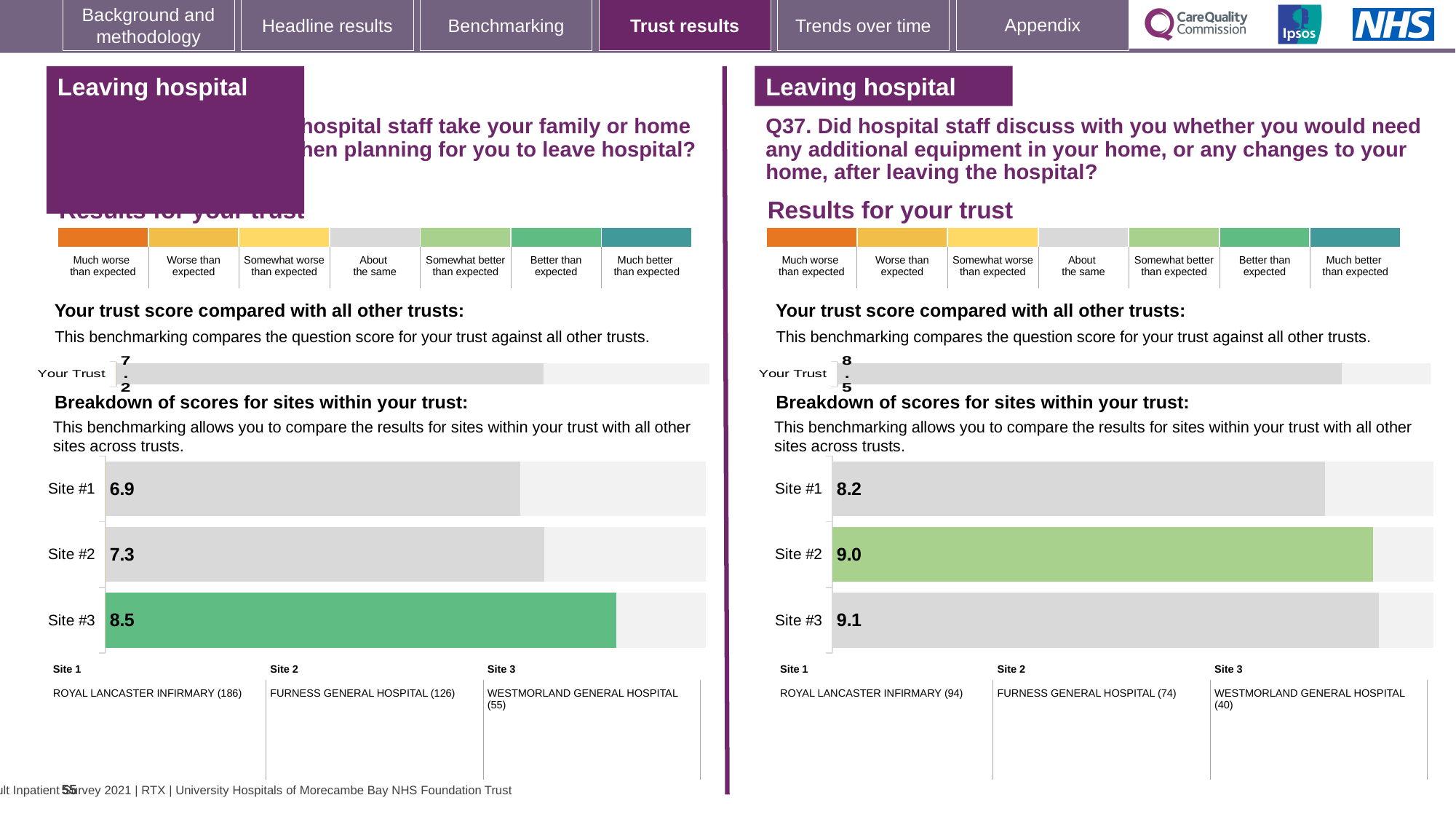
How many sites are shown on the right-hand (Q37) site breakdown chart? 3 On the right-hand (Q37) site breakdown chart, what is the score for Site #2? 9.0 On the right-hand (Q37) site breakdown chart, what is the score for Site #3? 9.1 What type of chart is used for the site breakdown on the left-hand side of the slide? Bar chart On the left-hand site breakdown chart, what is the score for Site #1? 6.9 On the left-hand site breakdown chart, which site has the lowest score? Site #1 On the right-hand (Q37) site breakdown chart, which site has the lowest score? Site #1 On the right-hand (Q37) site breakdown chart, what is the difference between the scores for Site #2 and Site #1? 0.8 On the left-hand site breakdown chart, which site has the highest score? Site #3 On the left-hand site breakdown chart, what is the score for Site #3? 8.5 On the left-hand site breakdown chart, what is the difference between the scores for Site #3 and Site #1? 1.6 On the left-hand site breakdown chart, which is larger: the score for Site #2 or Site #1? Site #2